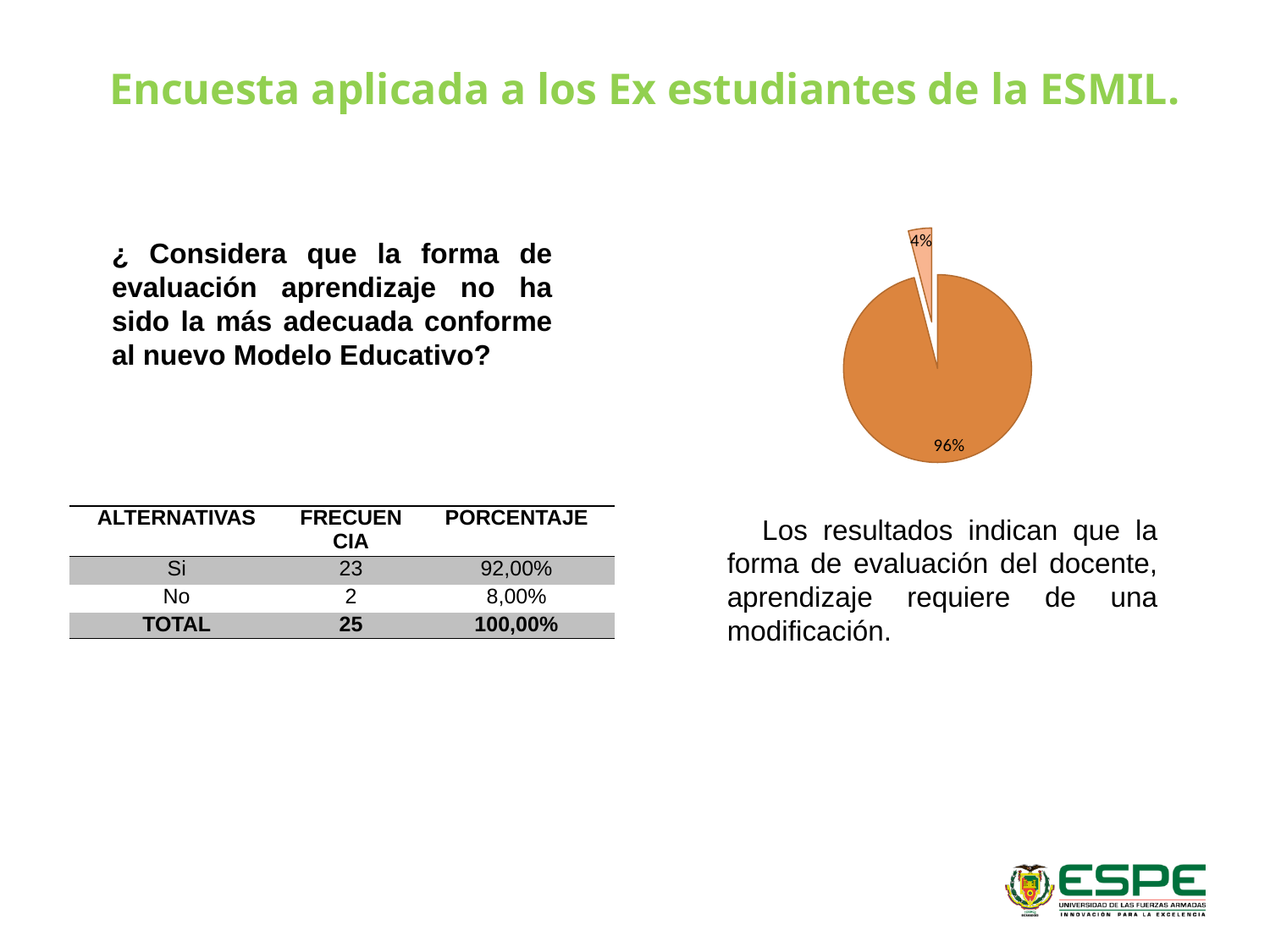
What share of the pie does the small, light-coloured slice represent? 4% What percentage is shown on the smallest slice of the pie chart? 4% What percentage is shown on the largest slice of the pie chart? 96% What colour is the largest slice of the pie chart? orange Is the value of the largest slice of the pie chart greater or less than 50%? greater How many slices does the pie chart have? 2 What is the difference in percentage points between the two slices of the pie chart? 92 Does the pie chart display a legend? No Is the value of the smallest slice of the pie chart greater or less than 10%? less What kind of chart is shown on the slide? pie chart Which slice of the pie chart is larger, the one labelled 96% or the one labelled 4%? 96%